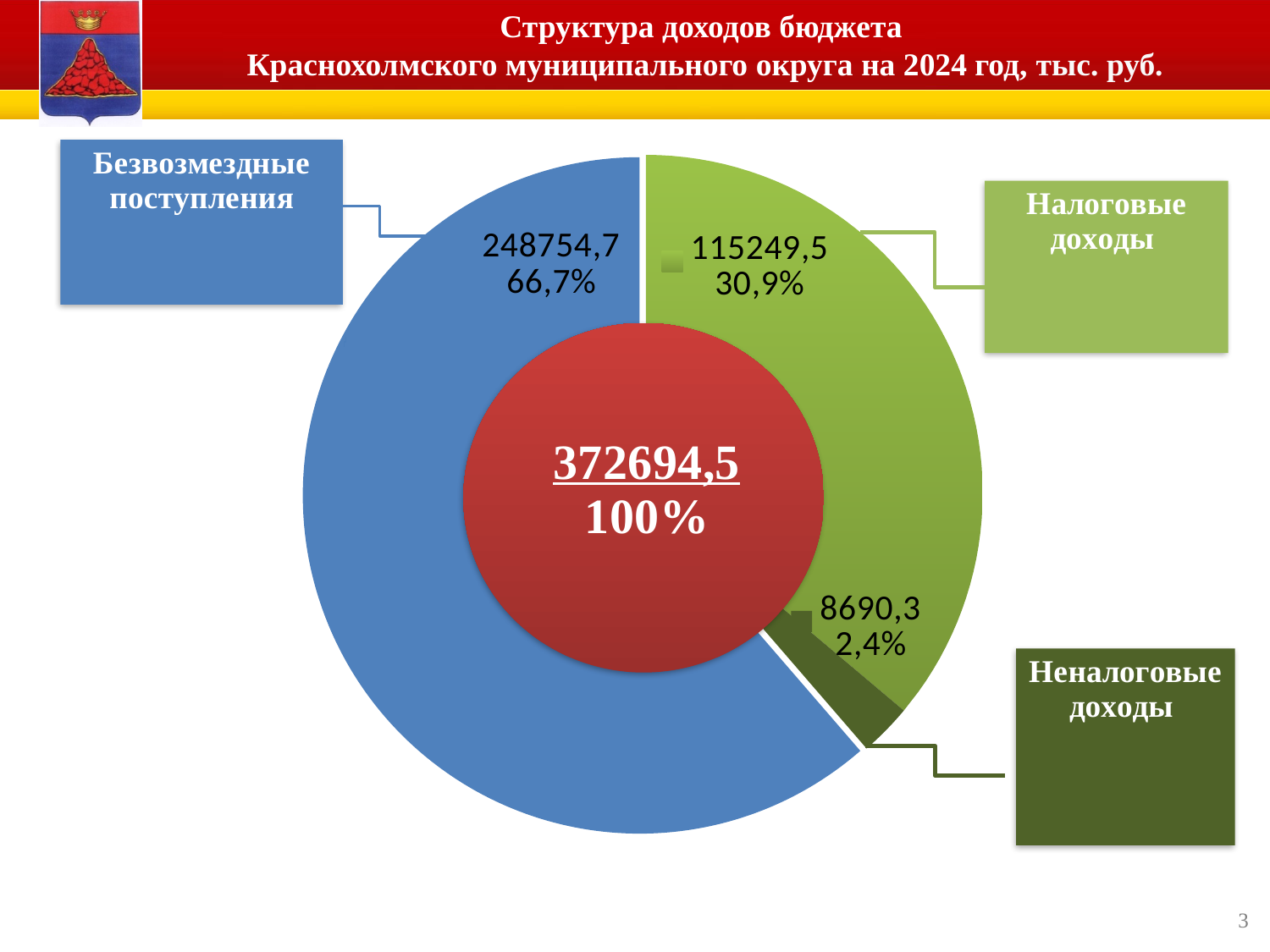
What is the value for Неналоговые доходы? 8690,3 Which category has the largest value? Безвозмездные поступления What is the value for Налоговые доходы? 115249,5 What share of the pie do Налоговые доходы make up? 30,9% Which is larger, Налоговые доходы or Неналоговые доходы? Налоговые доходы What total value is shown in the centre of the chart? 372694,5 What share of the pie do Безвозмездные поступления make up? 66,7% What share of the pie do Неналоговые доходы make up? 2,4% How many categories does the pie chart show? 3 Which category has the smallest value? Неналоговые доходы What is the value for Безвозмездные поступления? 248754,7 What kind of chart is shown on the slide? doughnut chart